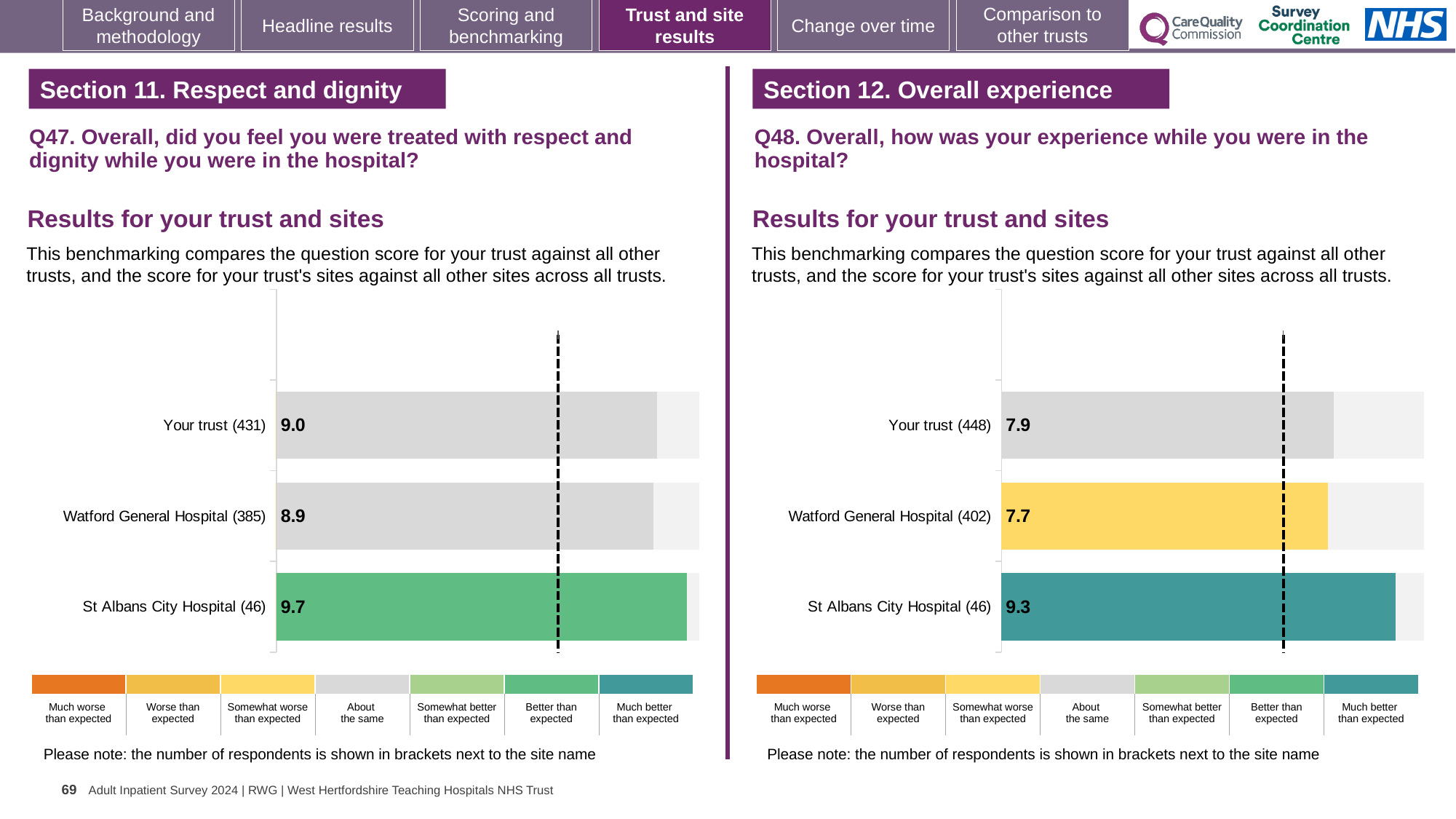
On the Q47 chart (left), which site or trust has the highest score? St Albans City Hospital On the Q48 chart (right), what is the difference between the scores for St Albans City Hospital and Your trust? 1.4 On the Q47 chart (left), what is the difference between the scores for St Albans City Hospital and Watford General Hospital? 0.8 On the Q48 chart (right), which benchmark category does the colour of the Watford General Hospital bar correspond to in the legend? Somewhat worse than expected On the Q47 chart (left), what is the score for Your trust? 9.0 How many bars are plotted on the Q47 chart (left)? 3 What type of chart is used for the Q48 results (right)? Bar chart On the Q48 chart (right), what is the score for Your trust? 7.9 On the Q48 chart (right), which has the larger score, Your trust or Watford General Hospital? Your trust On the Q47 chart (left), what is the score for Watford General Hospital? 8.9 On the Q48 chart (right), which site or trust has the lowest score? Watford General Hospital On the Q48 chart (right), what is the score for St Albans City Hospital? 9.3